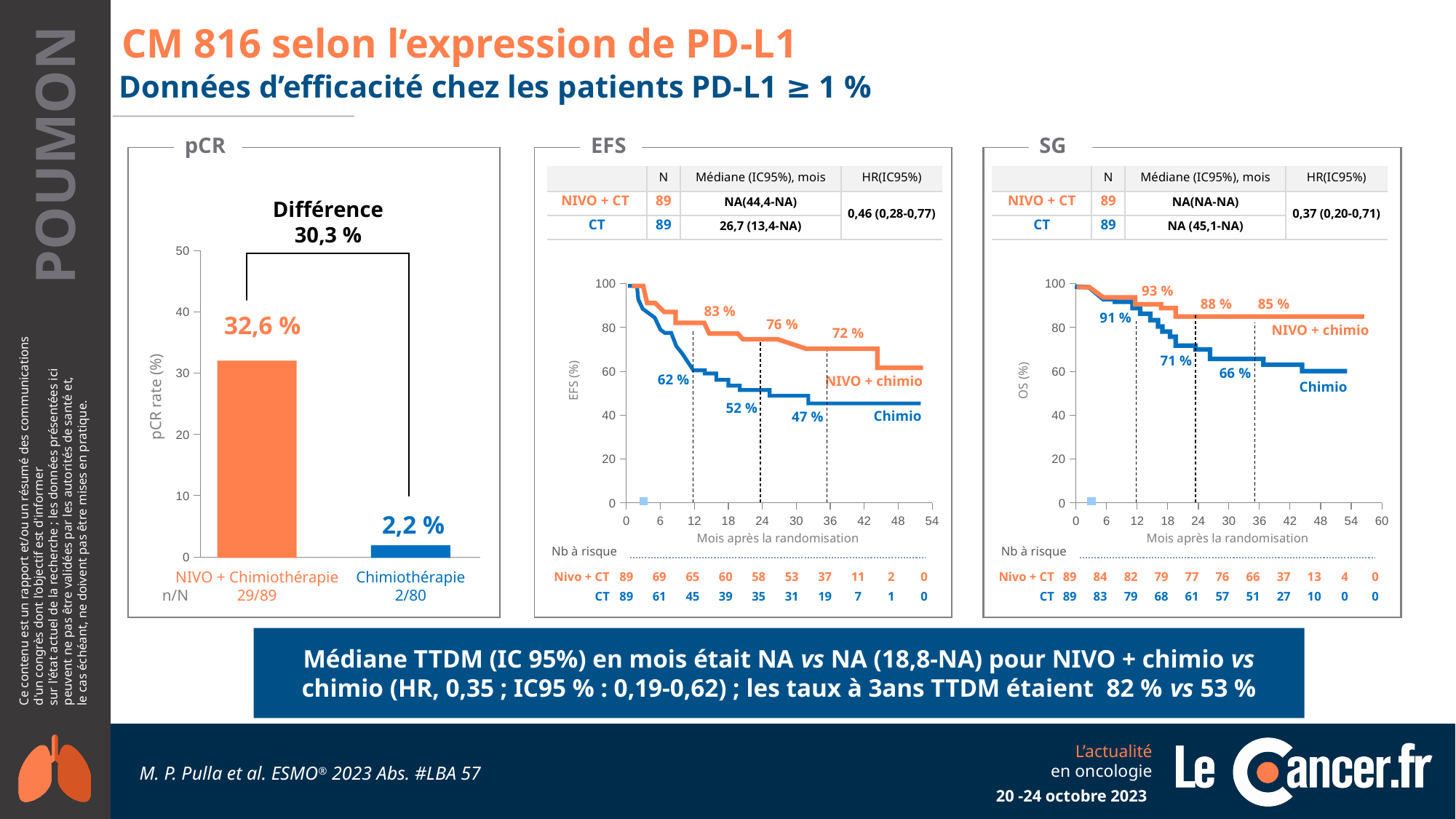
What kind of chart is the pCR chart? bar chart In the SG chart, what is the OS rate for NIVO + chimio at 12 months? 93 % How many curves (arms) are plotted in the EFS chart? 2 In the EFS chart, what is the EFS rate for NIVO + chimio at 36 months? 72 % In the EFS chart, what is the EFS rate for Chimio at 12 months? 62 % In the pCR chart, what is the difference in pCR rate between NIVO + Chimiothérapie and Chimiothérapie? 30,3 % In the pCR chart, what is the pCR rate for Chimiothérapie? 2,2 % In the SG chart, what is the OS rate for Chimio at 36 months? 66 % In the EFS chart, which arm has the higher EFS rate at 24 months, NIVO + chimio or Chimio? NIVO + chimio In the SG chart, what is the difference between the OS rates of NIVO + chimio and Chimio at 24 months? 17 % In the pCR chart, what is the pCR rate for NIVO + Chimiothérapie? 32,6 % How many categories are shown in the pCR bar chart? 2